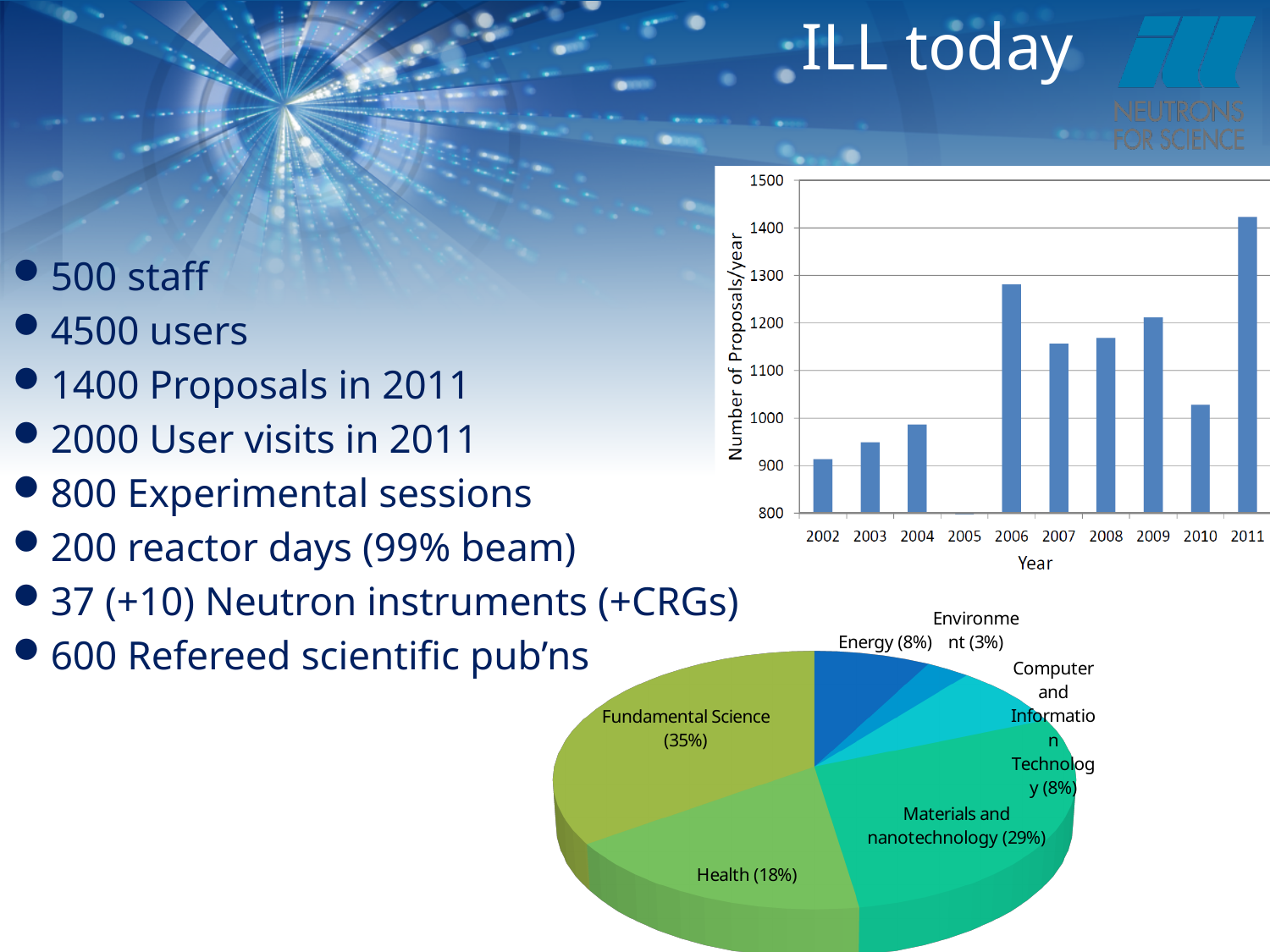
In the pie chart at the bottom of the slide, what share does Fundamental Science have? 35% In the bar chart of Number of Proposals/year, which year has the highest number of proposals? 2011 In the pie chart at the bottom of the slide, how many percentage points larger is Materials and nanotechnology than Health? 11 In the pie chart at the bottom of the slide, what share does Health have? 18% In the bar chart of Number of Proposals/year, is the value for 2011 greater or less than 1400? greater In the bar chart of Number of Proposals/year, is the value for 2010 greater or less than 1100? less How many years are shown on the x axis of the bar chart of Number of Proposals/year? 10 In the bar chart of Number of Proposals/year, which year has the larger value, 2006 or 2009? 2006 In the pie chart at the bottom of the slide, which category has the smallest share? Environment In the bar chart of Number of Proposals/year, is the value for 2006 greater or less than 1200? greater What is the title of the y axis of the bar chart at the top right of the slide? Number of Proposals/year What kind of chart is the chart at the top right of the slide, showing Number of Proposals/year? bar chart